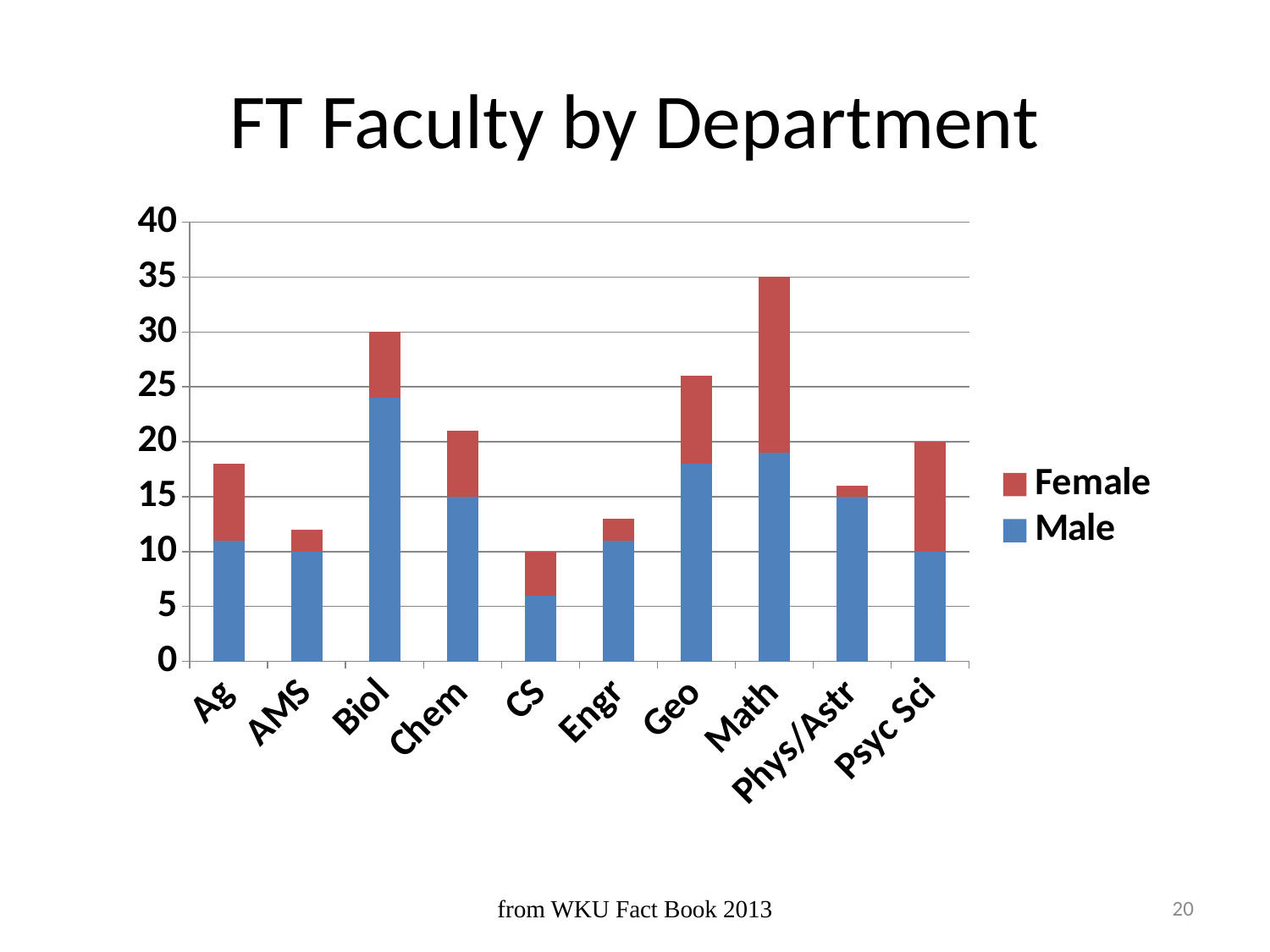
Is the total FT faculty for Geo greater or less than 25? greater Which department has the lowest total FT faculty? CS What is the total FT faculty for Math? 35 What is the total FT faculty for Biol? 30 What is the difference between the total FT faculty for Math and for Biol? 5 How many departments are shown on the x axis? 10 Which has a larger total FT faculty, Biol or Geo? Biol Which colour represents the Female series in the legend? Red Is the total FT faculty for Engr greater or less than 15? less What kind of chart is shown on the slide? Stacked bar chart Which department has the highest total FT faculty? Math How many series does the legend list? 2